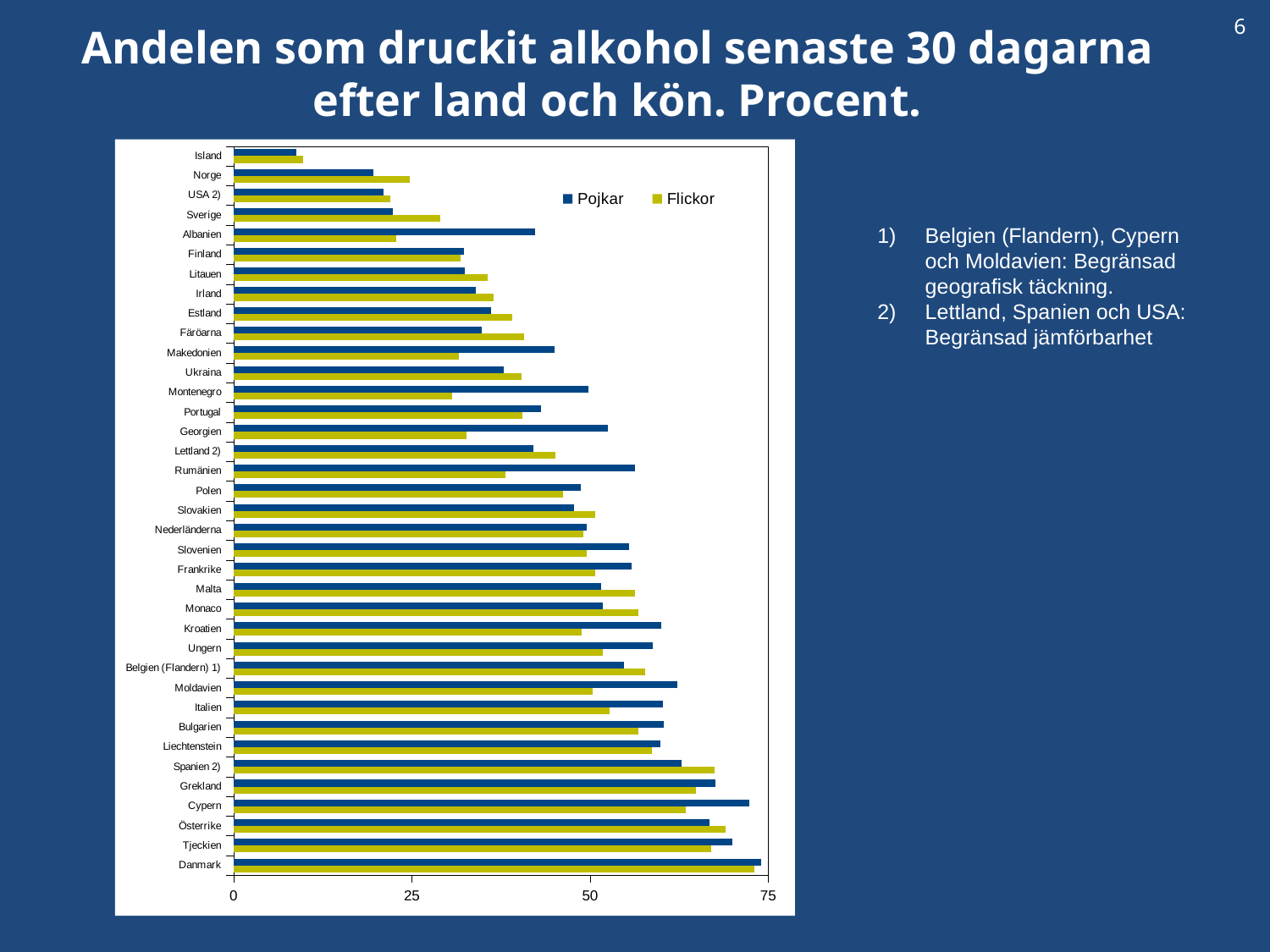
How many series does the legend list? 2 Is the value for Pojkar in Danmark greater or less than 50? greater In Albanien, which is larger, the value for Pojkar or for Flickor? Pojkar Which country has the lowest value for Pojkar? Island What kind of chart is shown on the slide? bar chart Is the value for Pojkar in Albanien greater or less than 25? greater Is the value for Pojkar in Island greater or less than 25? less Which series is shown in blue in the legend? Pojkar How many countries are listed on the chart? 37 Which country has the lowest value for Flickor? Island Which country has the highest value for Flickor? Danmark